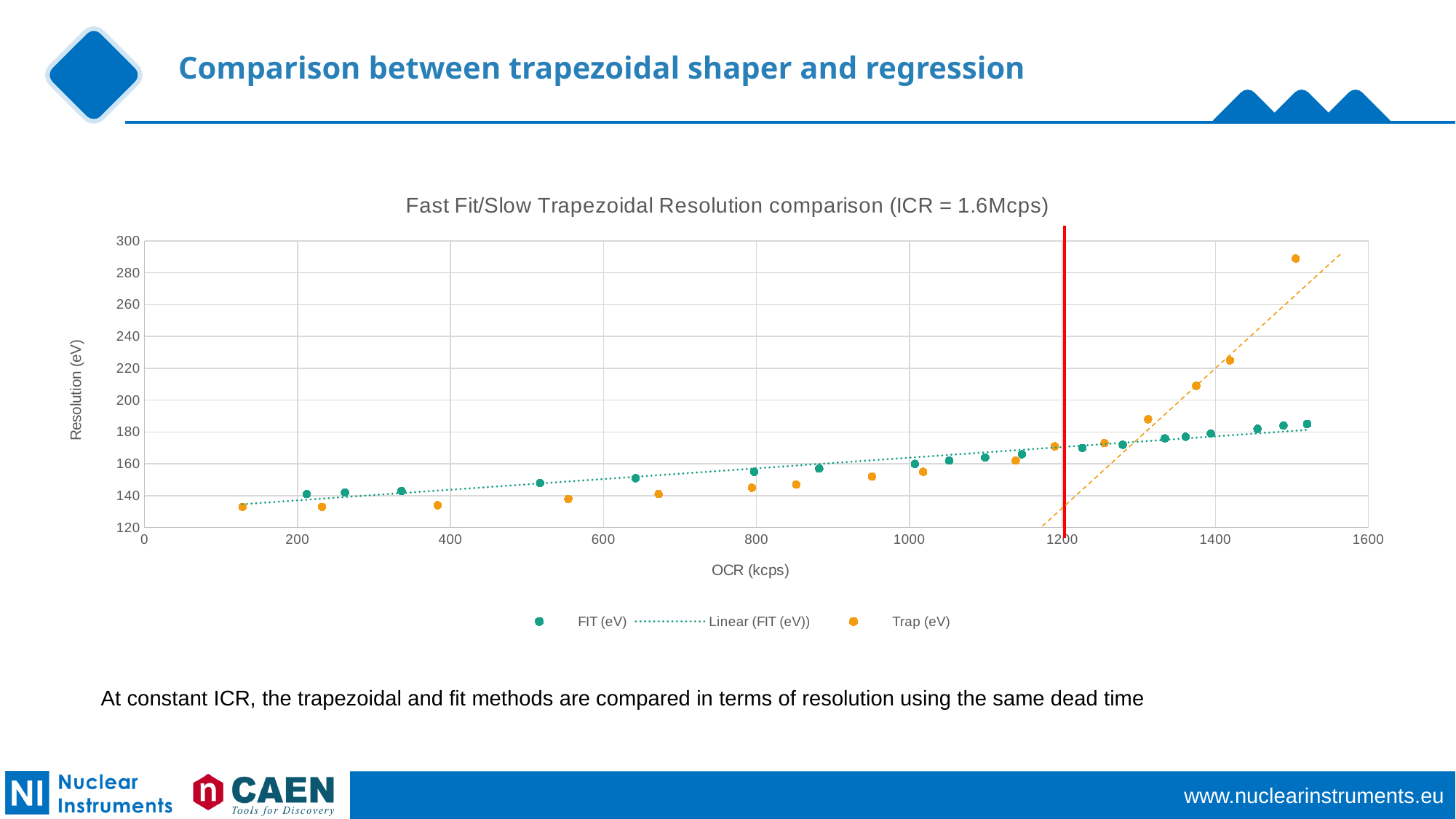
Which series reaches the highest resolution value on the chart, FIT (eV) or Trap (eV)? Trap (eV) What is the label of the x axis of the chart? OCR (kcps) Is the highest FIT (eV) value greater or less than 200? less At an OCR of about 1370 kcps, which series has the larger resolution value, FIT (eV) or Trap (eV)? Trap (eV) What kind of chart is shown on the slide? Scatter chart How many entries does the chart legend list? 3 Is the Trap (eV) value at the lowest OCR (about 130 kcps) greater or less than 140? less At an OCR of about 1500 kcps, which series has the larger resolution value, FIT (eV) or Trap (eV)? Trap (eV) Do the Trap (eV) values rise or fall as OCR increases? Rise Is the highest Trap (eV) value greater or less than 260? greater What is the title of the chart? Fast Fit/Slow Trapezoidal Resolution comparison (ICR = 1.6Mcps) Do the FIT (eV) values rise or fall as OCR increases? Rise